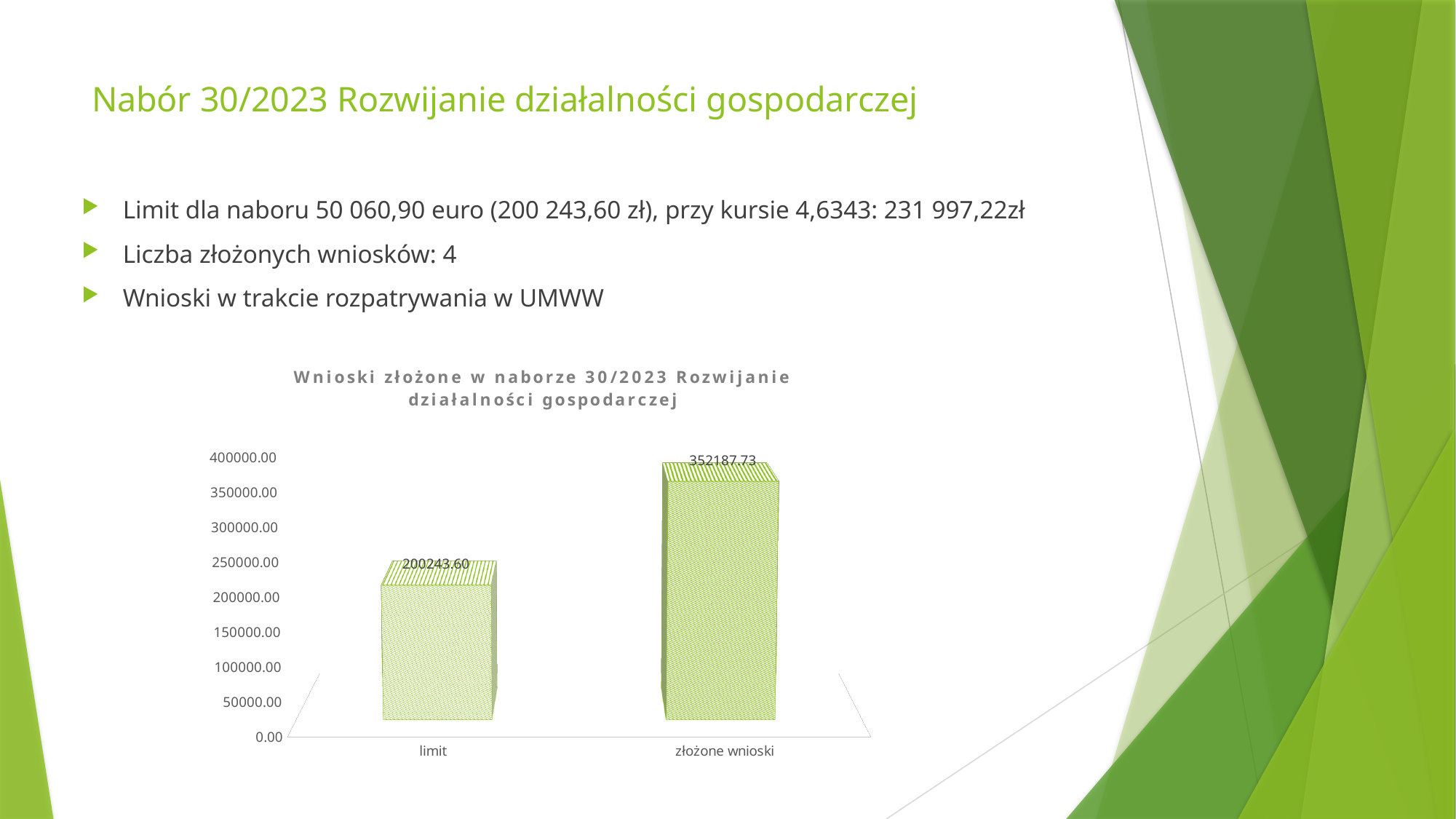
Is the value for 'złożone wnioski' greater or less than 300000.00? greater What kind of chart is shown on the slide? bar chart Which category has the highest value in the chart? złożone wnioski What is the difference between the 'złożone wnioski' value and the 'limit' value? 151944.13 What is the highest value labelled on the chart's vertical axis? 400000.00 What is the value of the 'limit' bar in the chart? 200243.60 What is the title of the chart? Wnioski złożone w naborze 30/2023 Rozwijanie działalności gospodarczej Which category has the lowest value in the chart? limit Which is larger, the value for 'limit' or the value for 'złożone wnioski'? złożone wnioski What is the value of the 'złożone wnioski' bar in the chart? 352187.73 Is the value for 'limit' greater or less than 250000.00? less How many categories are shown on the x axis of the chart? 2